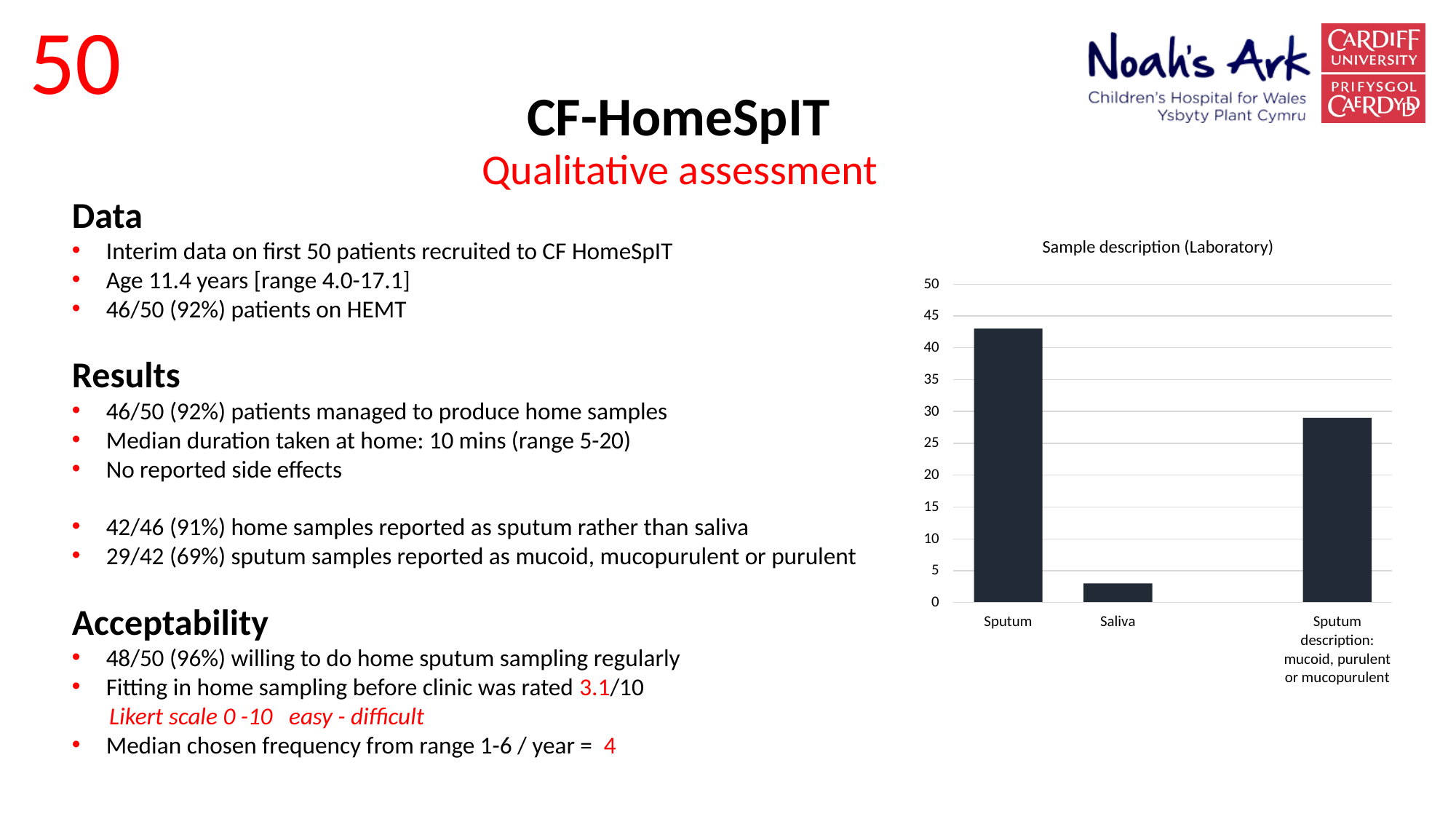
How many categories are shown on the x axis of the chart? 3 What type of chart is shown on the slide? bar chart Is the value for Saliva greater or less than 5? less Is the value for 'Sputum description: mucoid, purulent or mucopurulent' greater or less than 25? greater Is the value for Sputum greater or less than 40? greater Which is larger, the value for Sputum or the value for Saliva? Sputum What is the title of the chart? Sample description (Laboratory) What is the maximum value shown on the chart's y axis? 50 Which is larger, the value for Saliva or the value for 'Sputum description: mucoid, purulent or mucopurulent'? Sputum description: mucoid, purulent or mucopurulent Which category has the highest bar in the chart? Sputum Which category has the lowest bar in the chart? Saliva